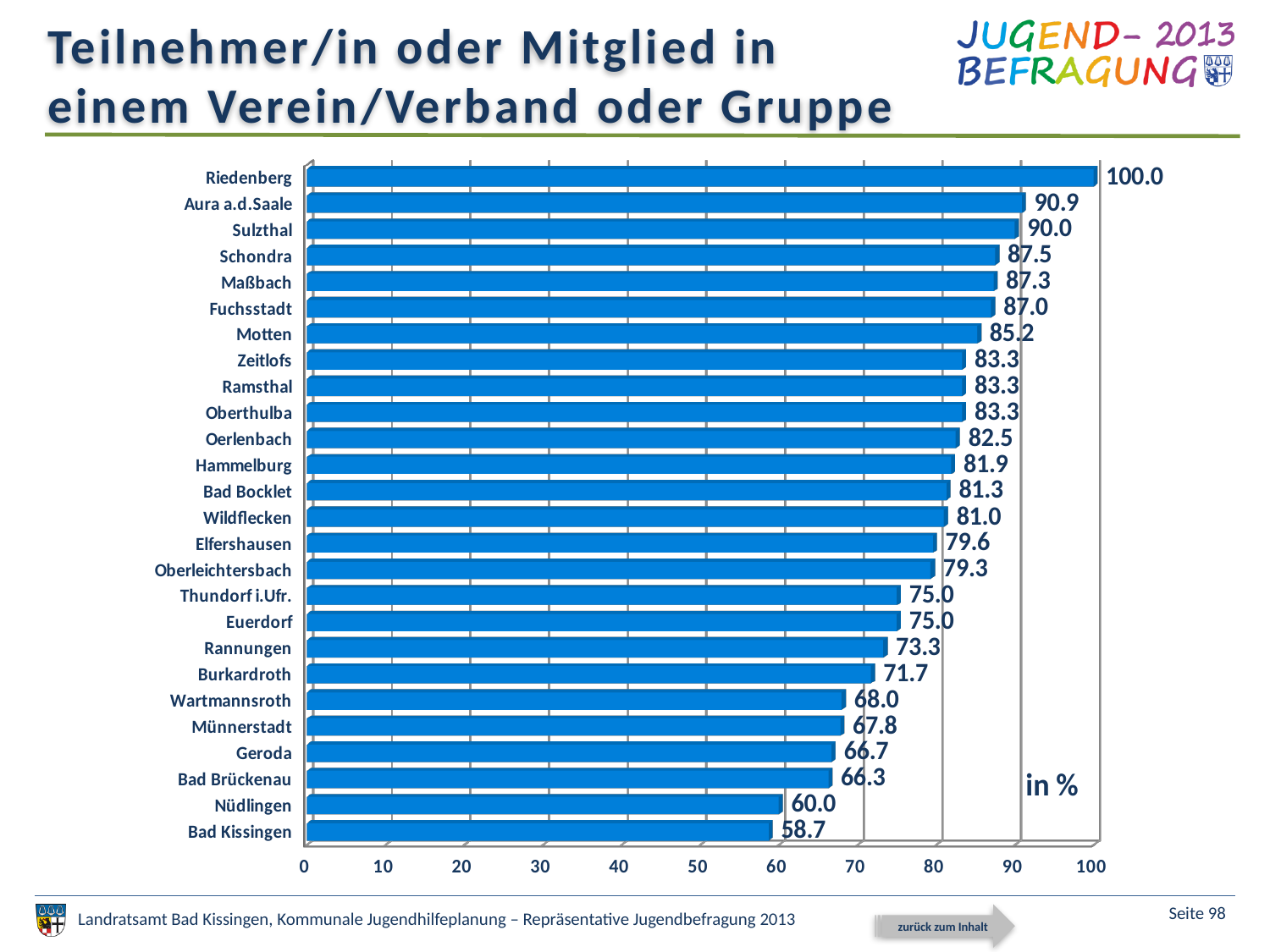
What is the value for Riedenberg? 100.0 What kind of chart is shown on the slide? Bar chart Which category has the highest value? Riedenberg What is the value for Bad Kissingen? 58.7 How many categories are shown in the chart? 26 What is the value for Wartmannsroth? 68.0 What is the difference between the values for Riedenberg and Bad Kissingen? 41.3 Which has a larger value, Schondra or Burkardroth? Schondra Which category has the lowest value? Bad Kissingen What is the difference between the values for Sulzthal and Nüdlingen? 30.0 What is the value for Hammelburg? 81.9 What unit is indicated by the label inside the chart area? in %